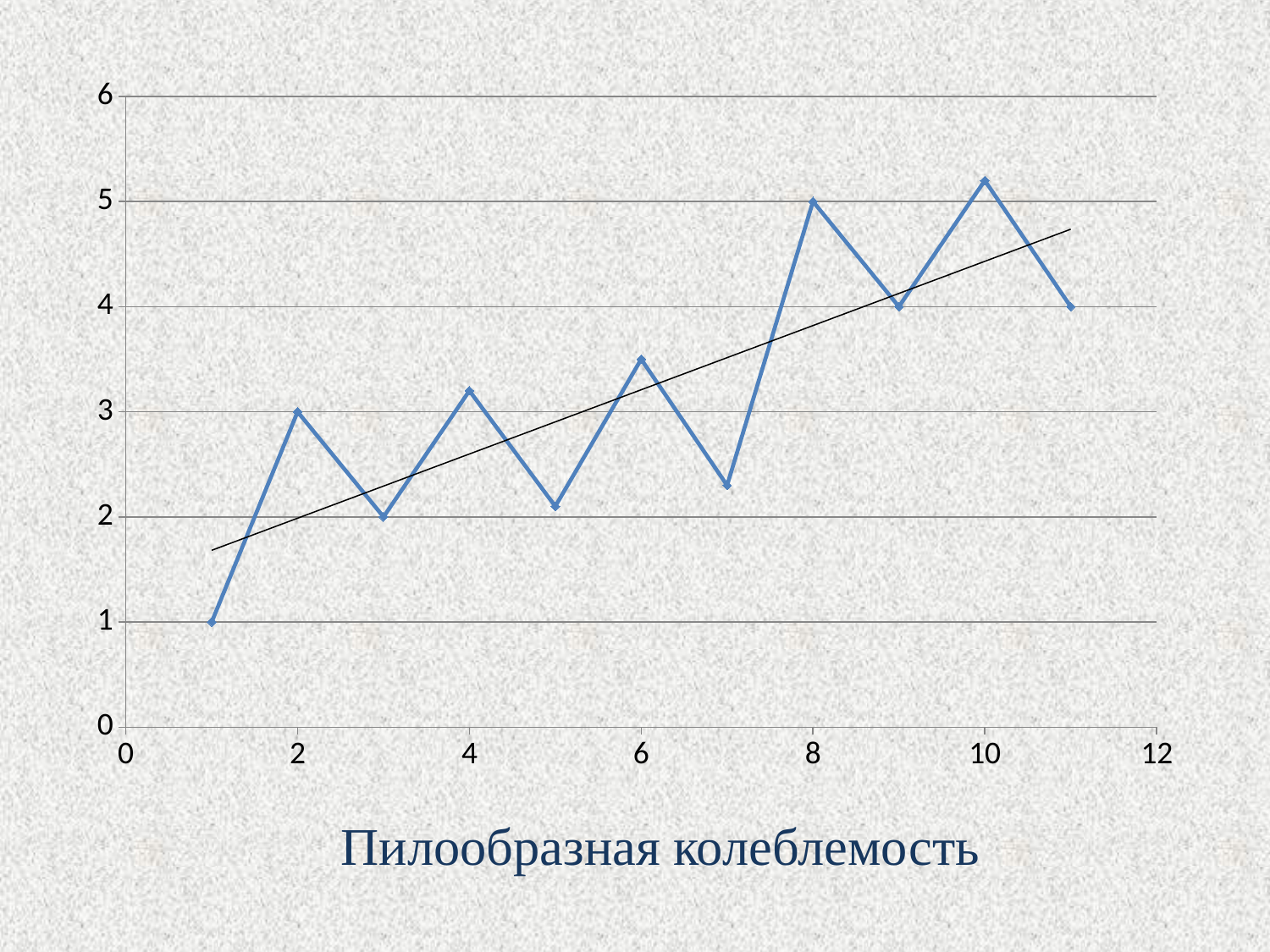
Which is larger, the value at x = 8 or the value at x = 9? x = 8 At which x value does the blue line reach its highest point? 10 What kind of chart is shown on the slide? line chart Does the straight trend line rise or fall from left to right? rises At which x value does the blue line reach its lowest point? 1 What is the value of the blue line at x = 11? 4 What is the difference between the values at x = 2 and x = 1? 2 What is the value of the blue line at x = 1? 1 What is the value of the blue line at x = 8? 5 What is the value of the blue line at x = 2? 3 How many data points are plotted on the blue line? 11 Is the value at x = 10 greater or less than 5? greater